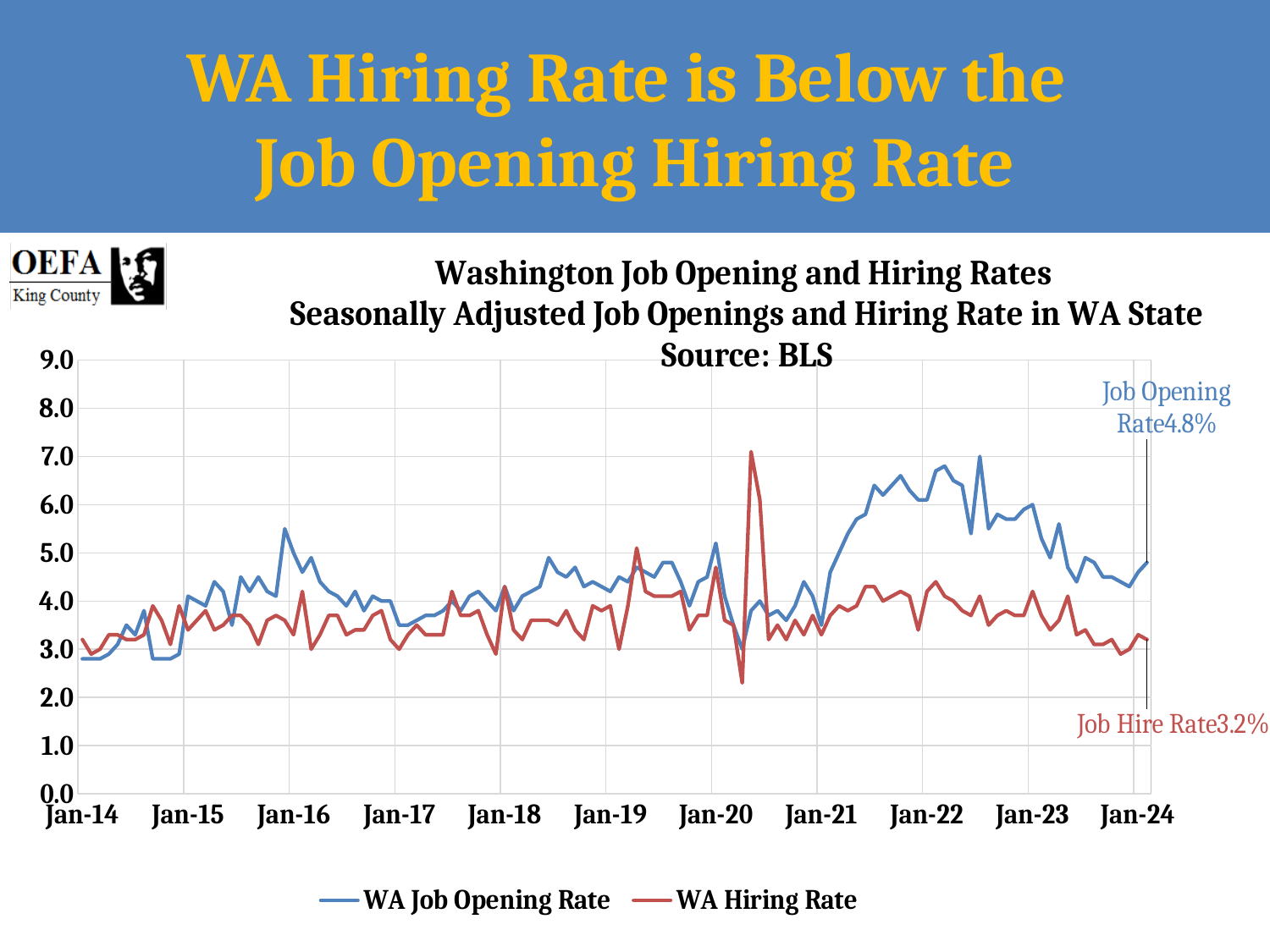
Does the WA Job Opening Rate rise or fall between Jan-21 and Jan-22? Rise How many year labels are shown on the x axis? 11 Does the WA Job Opening Rate rise or fall between Jan-22 and Jan-24? Fall Is the WA Job Opening Rate at Jan-21 greater or less than 4.0? less What is the difference between the labelled Job Opening Rate (4.8%) and the labelled Job Hire Rate (3.2%)? 1.6 percentage points How many series does the legend list? 2 At the end of the series, which is larger: the WA Job Opening Rate or the WA Hiring Rate? WA Job Opening Rate What is the latest WA Job Opening Rate labelled on the chart? 4.8% What kind of chart is shown on the slide? Line chart Is the WA Hiring Rate at its 2020 spike greater or less than 6.0? greater Which colour represents the WA Hiring Rate in the chart? Red What is the latest WA Job Hire Rate labelled on the chart? 3.2%